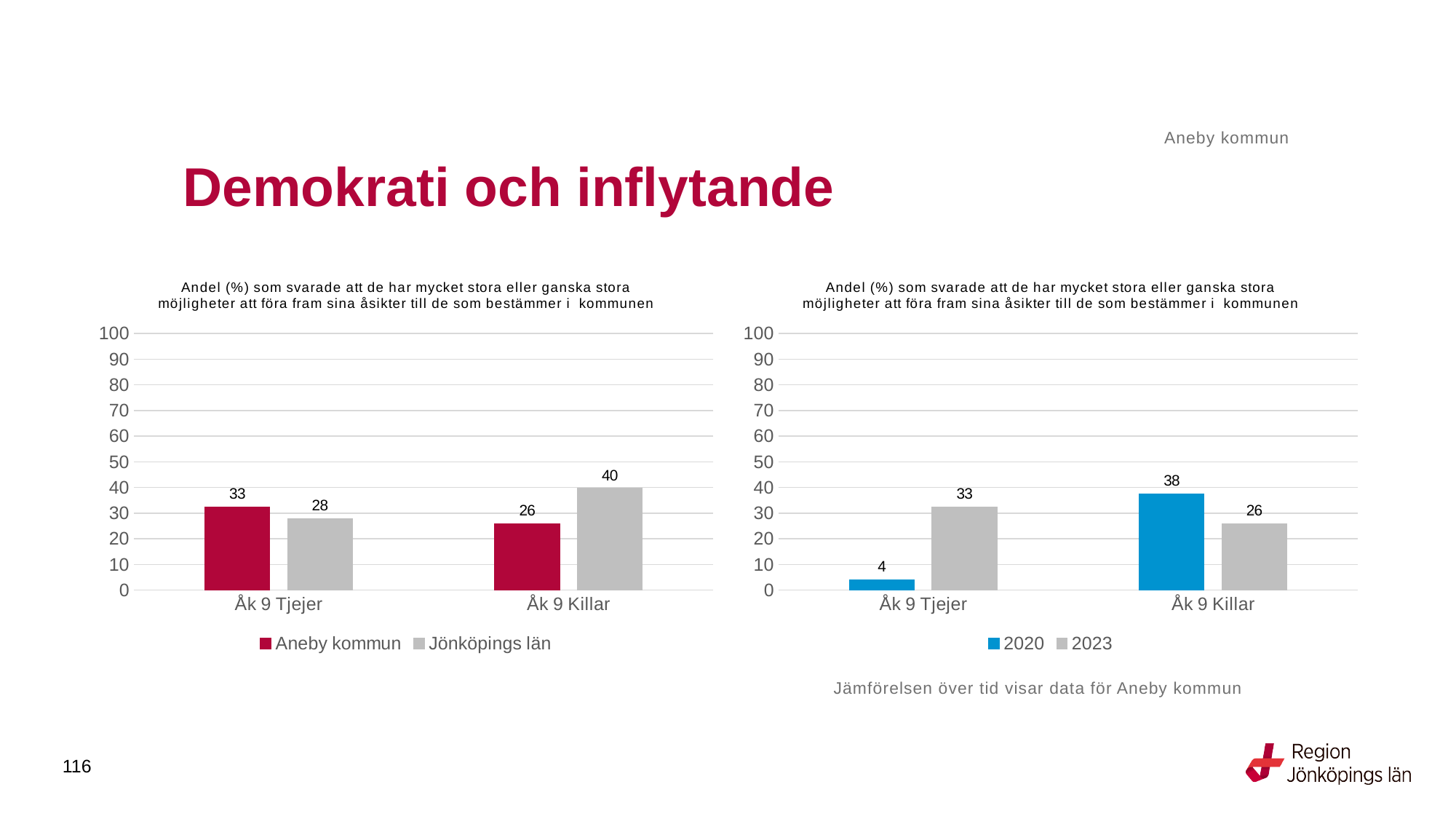
What kind of chart is the right chart? Bar chart In the right chart, which is larger for Åk 9 Killar: 2020 or 2023? 2020 In the left chart, how many series does the legend list? 2 In the left chart, what is the value for Aneby kommun for Åk 9 Tjejer? 33 In the right chart, what is the difference between 2023 and 2020 for Åk 9 Tjejer? 29 In the left chart, what is the value for Jönköpings län for Åk 9 Killar? 40 In the left chart, what is the difference between Jönköpings län and Aneby kommun for Åk 9 Killar? 14 In the right chart, what is the value for 2023 for Åk 9 Killar? 26 In the right chart, what is the value for 2020 for Åk 9 Tjejer? 4 In the left chart, which is larger for Åk 9 Tjejer: Aneby kommun or Jönköpings län? Aneby kommun In the right chart, what colour are the 2020 bars? Blue In the right chart, which bar is the lowest? 2020, Åk 9 Tjejer